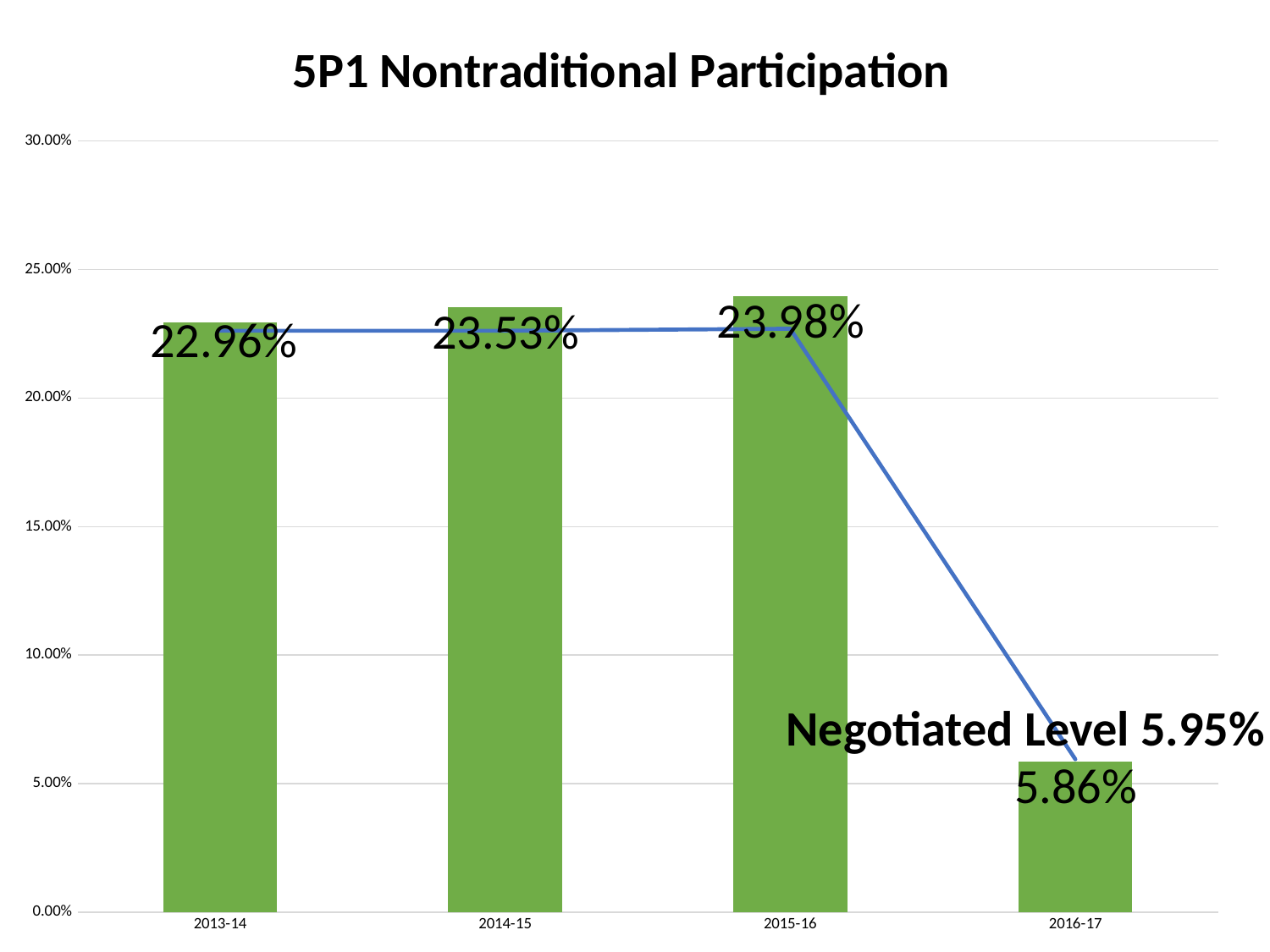
What kind of chart is this? Combination bar and line chart What is the value for 2013-14? 22.96% What is the value for 2014-15? 23.53% Which is larger, the value for 2013-14 or the value for 2014-15? 2014-15 Which year has the highest value? 2015-16 How many years are shown on the x axis? 4 What is the difference between the values for 2015-16 and 2016-17? 18.12% Which year has the lowest value? 2016-17 What is the value for 2015-16? 23.98% What negotiated level is annotated on the chart? 5.95% What is the title of the chart? 5P1 Nontraditional Participation What is the value for 2016-17? 5.86%